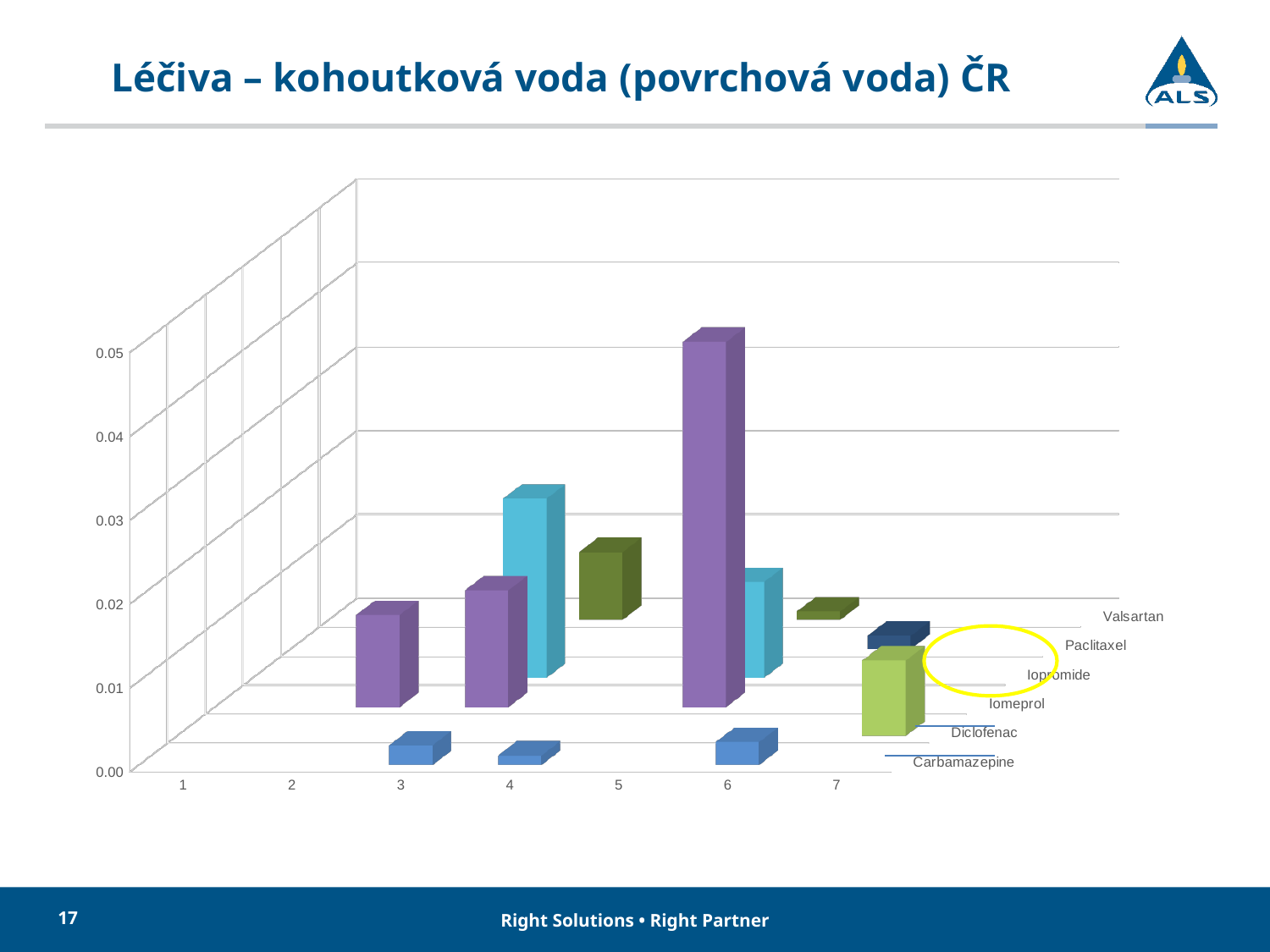
Which series name on the chart is circled in yellow? Iopromide How many series names are listed along the depth axis of the chart? 6 What kind of chart is shown on the slide? bar chart What is the highest value labelled on the vertical axis of the chart? 0.05 At which x-axis category does the tallest bar in the chart appear? 5 How many numbered categories are shown along the x axis of the chart? 7 Which series has the tallest bar in the chart? Iomeprol Is the value for Carbamazepine at category 3 greater or less than 0.01? less What is the title of the slide containing the chart? Léčiva – kohoutková voda (povrchová voda) ČR